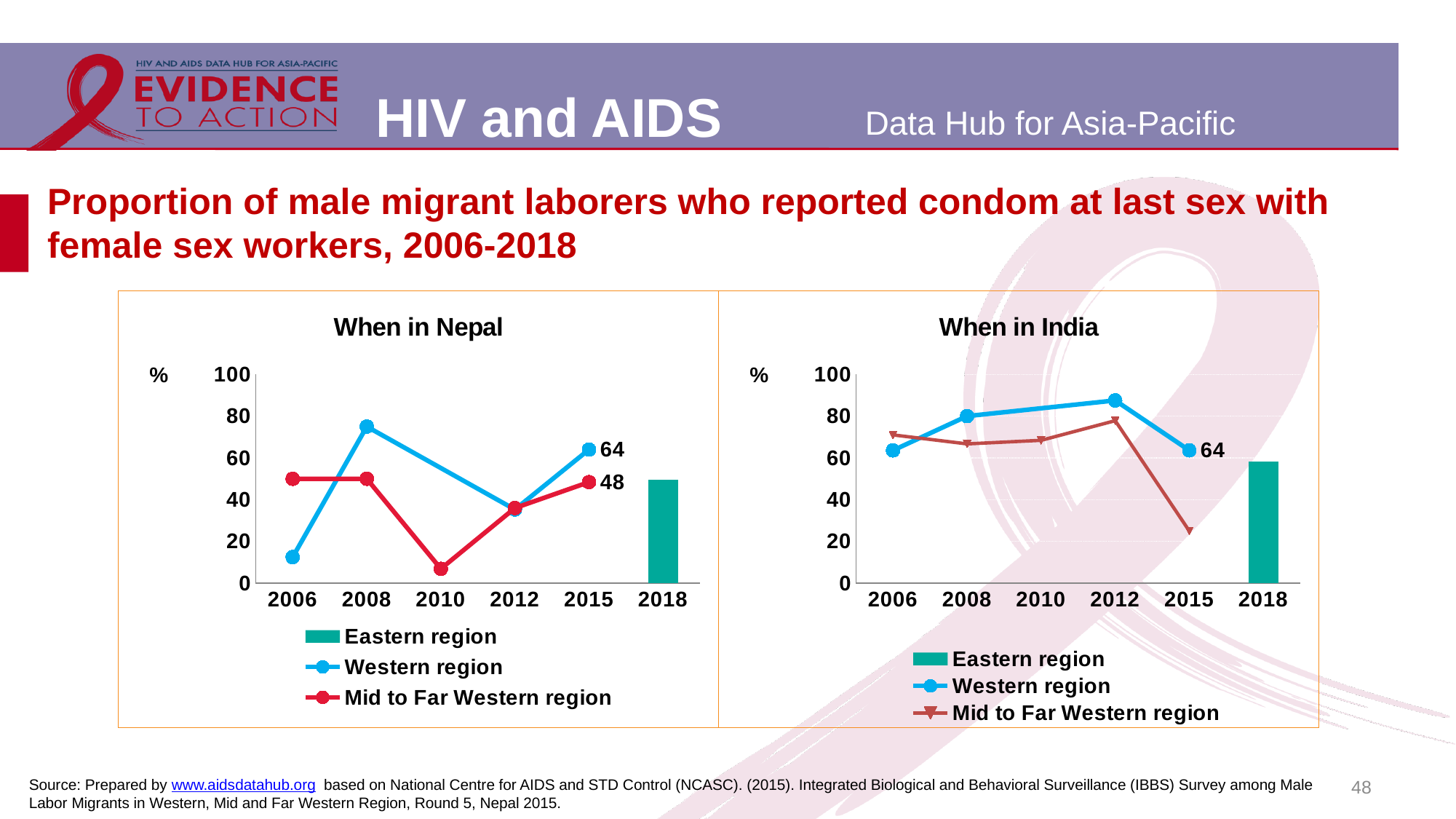
In the 'When in India' chart, what is the value for the Western region in 2015? 64 In the 'When in India' chart, is the value for the Mid to Far Western region in 2015 greater or less than 40? less In the 'When in Nepal' chart, what is the difference between the Western region and the Mid to Far Western region values in 2015? 16 In the 'When in Nepal' chart, is the value for the Mid to Far Western region in 2010 greater or less than 20? less In the 'When in Nepal' chart, what is the value for the Mid to Far Western region in 2015? 48 In the 'When in India' chart, in which year does the Western region reach its highest value? 2012 In the 'When in Nepal' chart, what is the value for the Western region in 2015? 64 In the 'When in Nepal' chart, is the value for the Western region in 2008 greater or less than 60? greater In the 'When in India' chart, how many years are shown on the x axis? 6 In the 'When in India' chart, does the Mid to Far Western region value rise or fall from 2012 to 2015? fall In the 'When in Nepal' chart, how many series does the legend list? 3 In the 'When in Nepal' chart, which region has the higher value in 2015, Western region or Mid to Far Western region? Western region